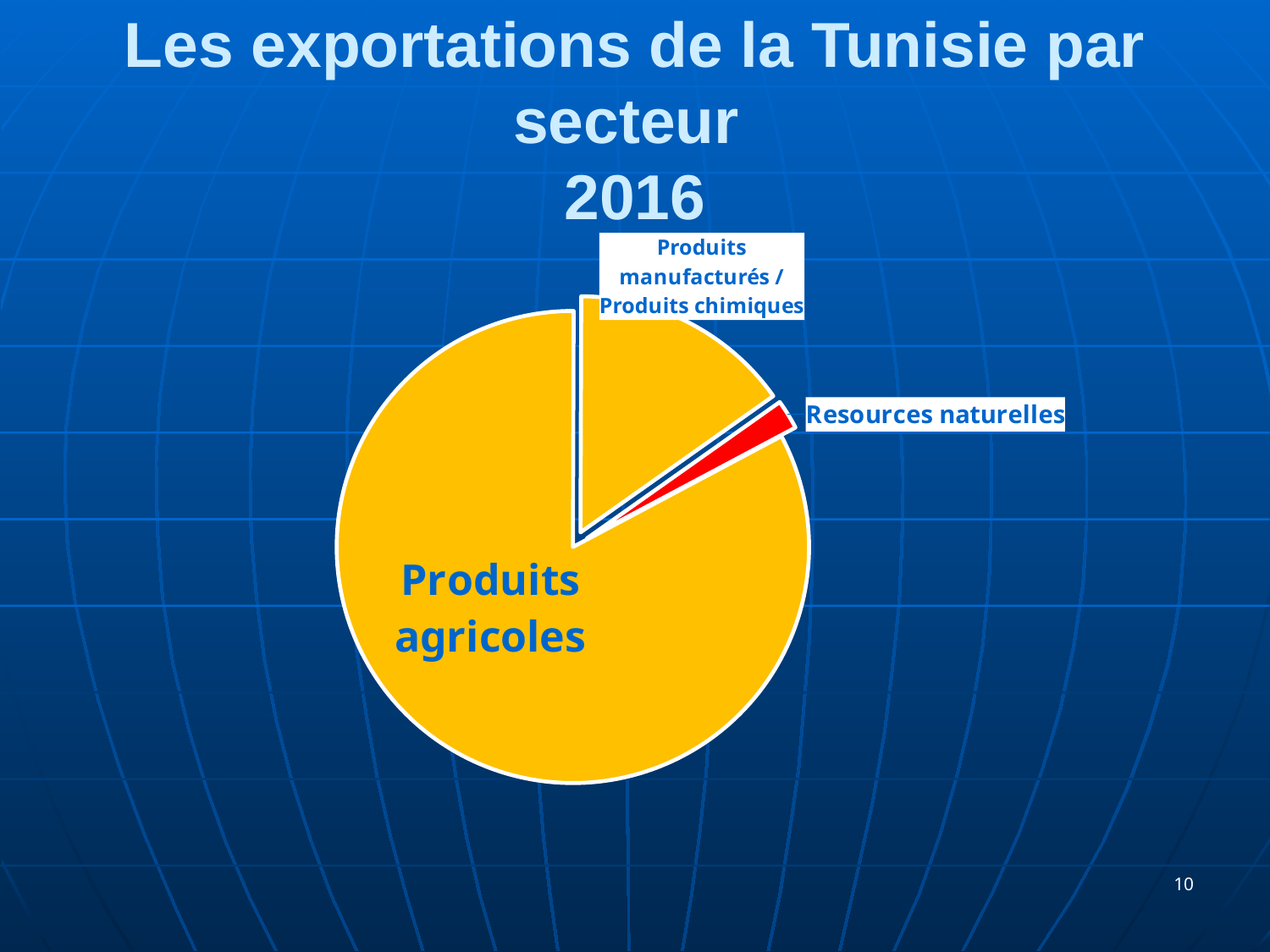
Which sector has the smallest slice of the pie chart? Resources naturelles What kind of chart is shown on the slide? Pie chart Which sector has the largest slice of the pie chart? Produits agricoles Which slice is larger: Produits agricoles or Produits manufacturés / Produits chimiques? Produits agricoles Which slice is larger: Produits manufacturés / Produits chimiques or Resources naturelles? Produits manufacturés / Produits chimiques What colour is the Resources naturelles slice in the pie chart? Red How many slices does the pie chart have? 3 Does the Produits agricoles slice represent more or less than half of the pie? more What is the title of the slide containing the pie chart? Les exportations de la Tunisie par secteur 2016